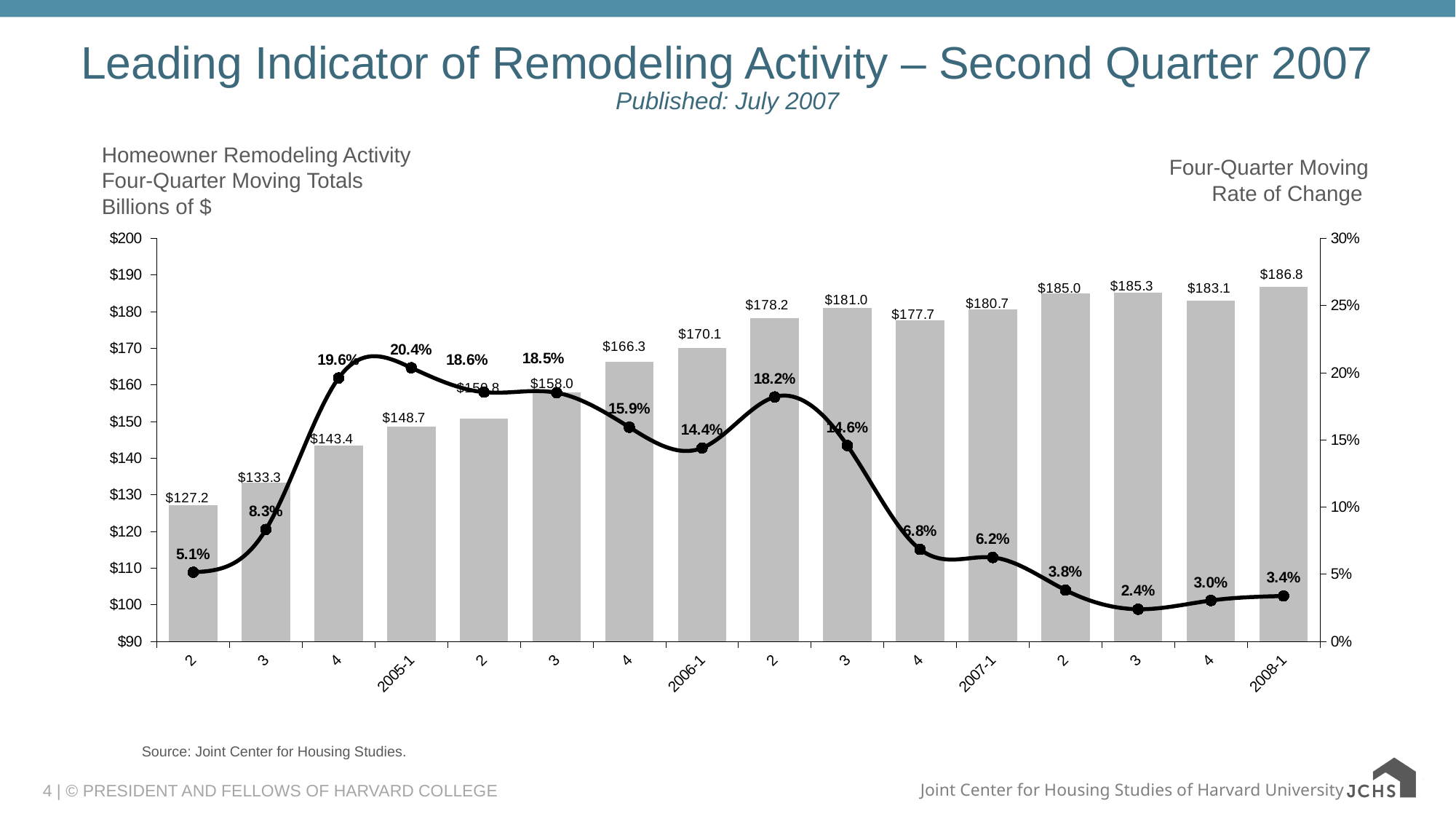
What is the lowest four-quarter moving rate of change shown? 2.4% What kind of chart is shown? Combination bar and line chart Which has the larger four-quarter moving total, 2006-1 or 2007-1? 2007-1 Do the four-quarter moving totals rise or fall from 2005-1 to 2006-1? Rise What is the highest four-quarter moving rate of change shown? 20.4% What is the four-quarter moving total for 2008-1? $186.8 How much higher is the four-quarter moving total for 2008-1 than for 2007-1? $6.1 Which quarter has the highest four-quarter moving total? 2008-1 What is the four-quarter moving total for 2006-1? $170.1 How many quarters are plotted along the x axis? 16 What is the lowest four-quarter moving total shown on the chart? $127.2 What is the four-quarter moving rate of change at 2005-1? 20.4%